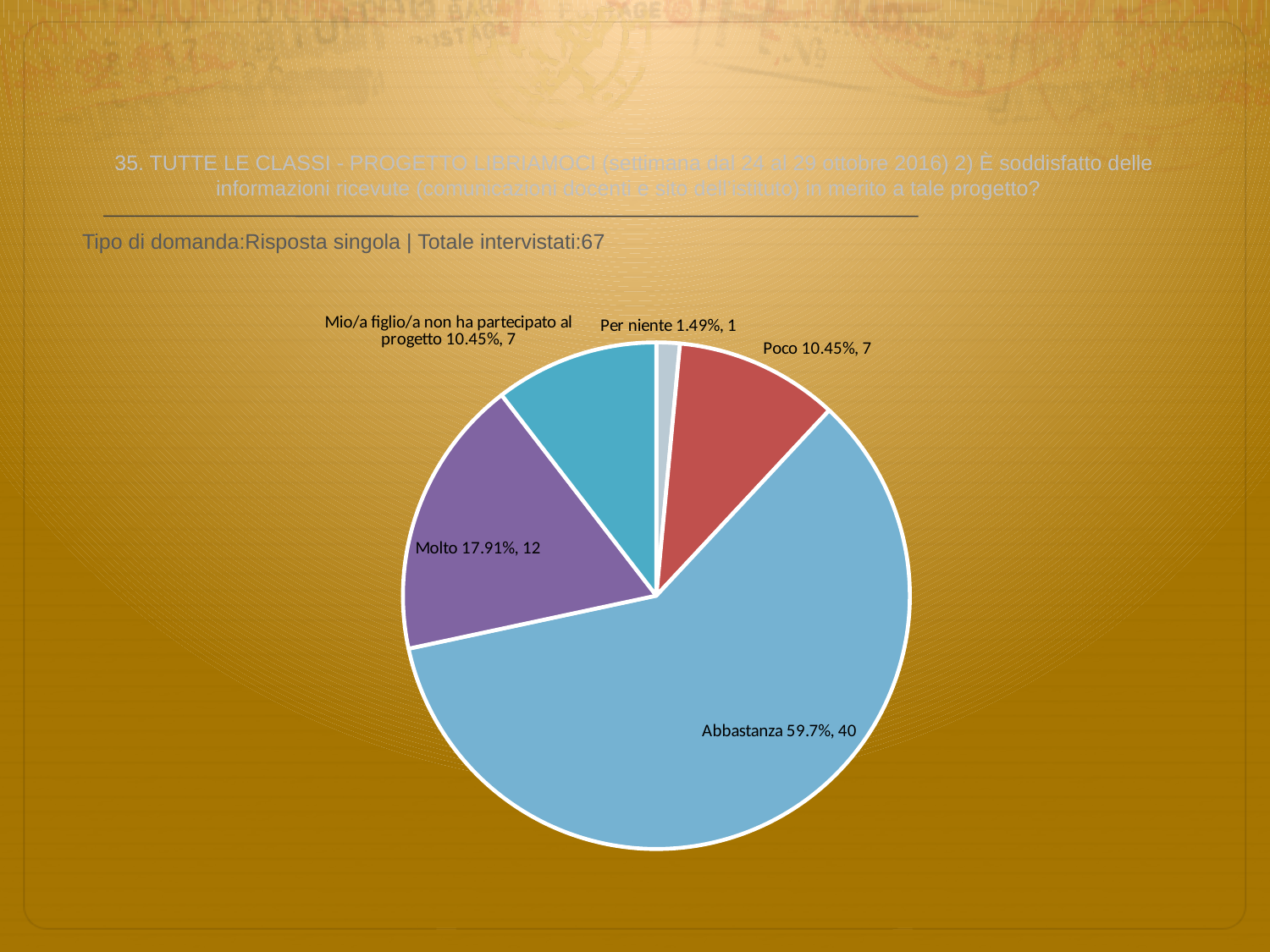
What percentage share does the "Abbastanza" slice have? 59.7% Which has more respondents, "Molto" or "Poco"? Molto What is the total number of respondents (Totale intervistati) stated on the slide? 67 What kind of chart is shown on the slide? Pie chart How many slices does the pie chart have? 5 What percentage share does the "Molto" slice have? 17.91% Which category has the largest slice of the pie? Abbastanza Which category has the smallest slice of the pie? Per niente What is the difference in respondent count between "Abbastanza" and "Molto"? 28 What percentage share does the "Mio/a figlio/a non ha partecipato al progetto" slice have? 10.45% How many respondents answered "Molto"? 12 How many respondents answered "Per niente"? 1